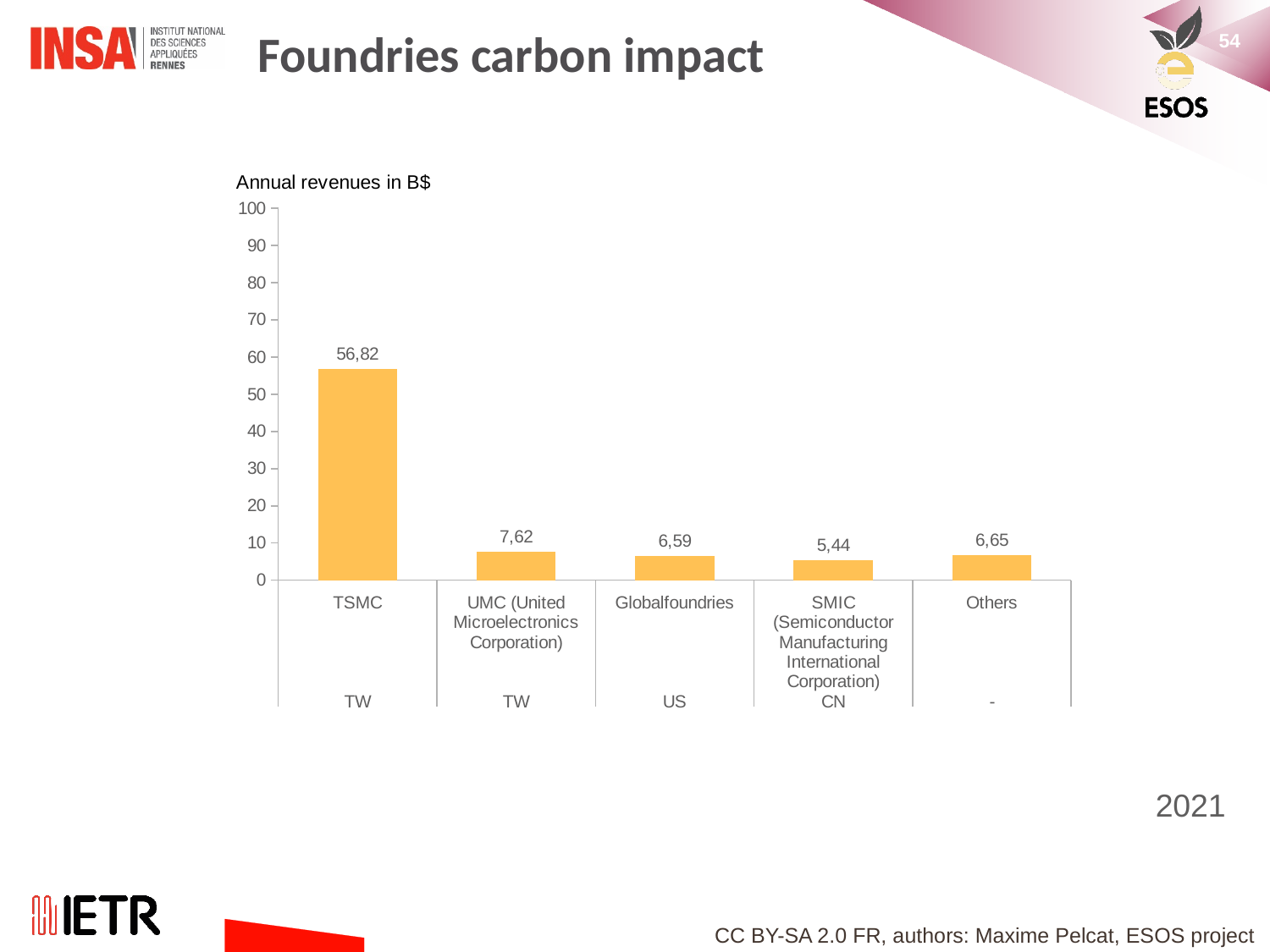
What kind of chart is shown on the slide? bar chart Is the value for TSMC greater or less than 50? greater What is the annual revenue shown for TSMC? 56,82 Which foundry has the highest annual revenue in the chart? TSMC What is the annual revenue shown for Others? 6,65 Which has the larger annual revenue, UMC (United Microelectronics Corporation) or SMIC (Semiconductor Manufacturing International Corporation)? UMC (United Microelectronics Corporation) What is the annual revenue shown for Globalfoundries? 6,59 What is the annual revenue shown for SMIC (Semiconductor Manufacturing International Corporation)? 5,44 What is the annual revenue shown for UMC (United Microelectronics Corporation)? 7,62 What is the difference in annual revenue between TSMC and UMC (United Microelectronics Corporation)? 49,20 Which category has the lowest annual revenue in the chart? SMIC (Semiconductor Manufacturing International Corporation) How many categories are shown on the x axis of the chart? 5